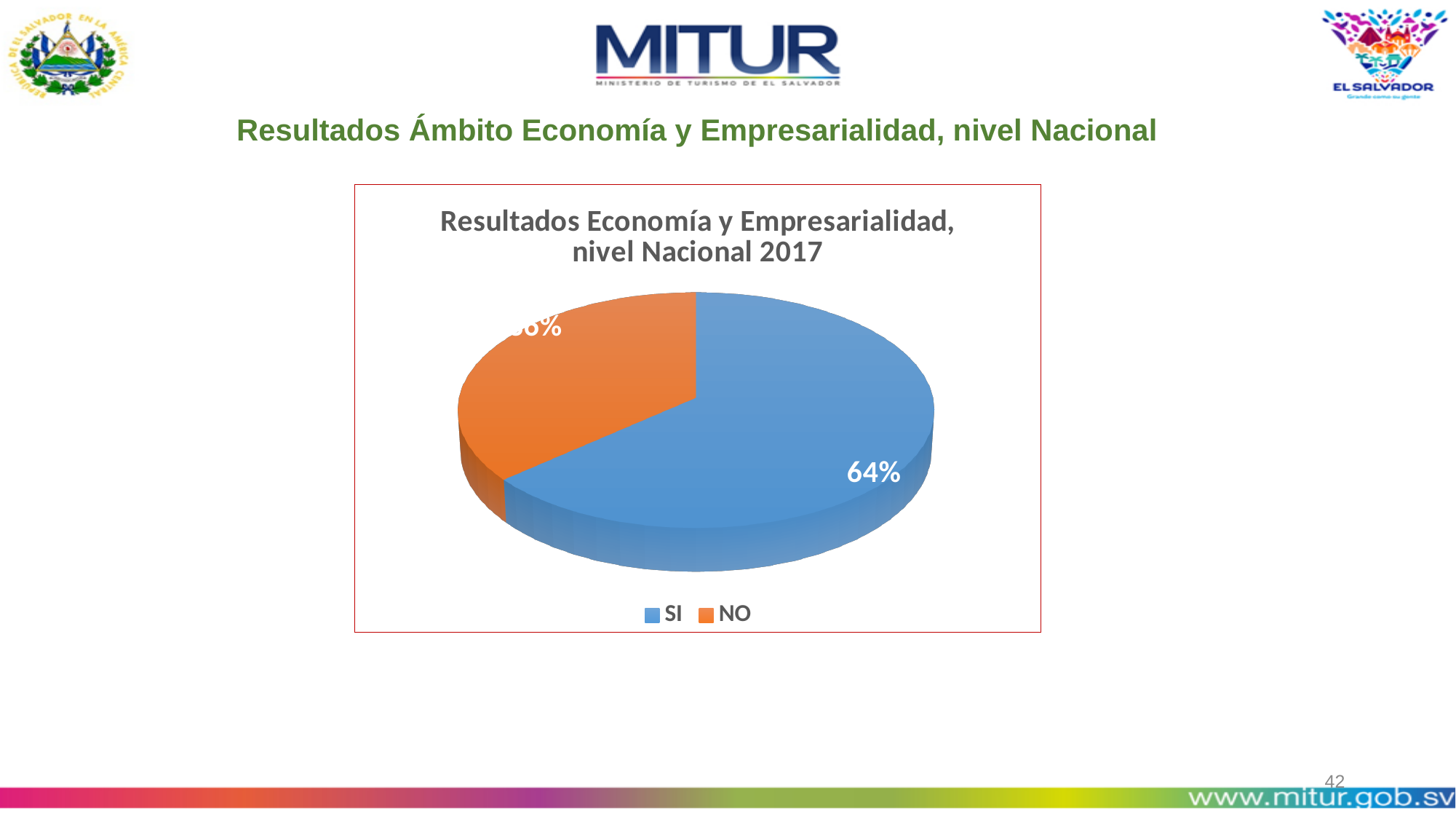
Which category has the largest slice in the pie chart? SI What percentage does the SI slice represent in the pie chart? 64% What colour is the NO slice in the pie chart? orange How many entries does the legend of the pie chart list? 2 Is the value for SI greater or less than 50%? greater What share of the pie does the SI slice take? 64% Is the value for NO greater or less than 50%? less Which category has the smallest slice in the pie chart? NO What is the title of the pie chart? Resultados Economía y Empresarialidad, nivel Nacional 2017 How many slices does the pie chart have? 2 Which slice is larger in the pie chart, SI or NO? SI What kind of chart is shown on the slide? pie chart